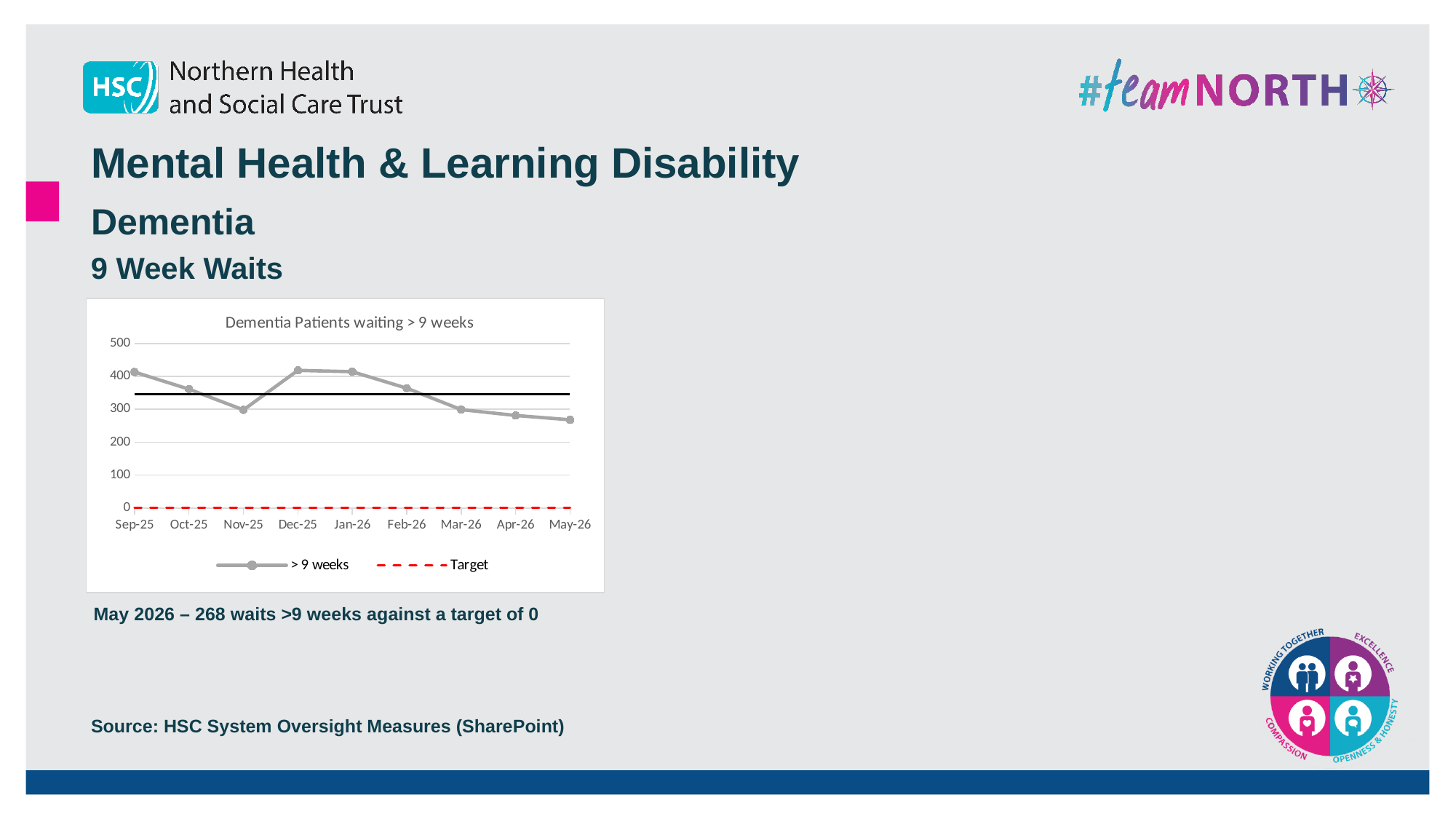
How many months are plotted along the x axis of the chart? 9 Is the value for > 9 weeks in Apr-26 greater or less than 300? less Is the value for > 9 weeks in Dec-25 greater or less than 400? greater Do the > 9 weeks values rise or fall from Jan-26 to May-26? fall How is the Target series drawn on the chart? red dashed line Is the value for > 9 weeks in Feb-26 greater or less than 400? less What is the value of the Target line on the chart? 0 Which is larger, the > 9 weeks value for Sep-25 or for Nov-25? Sep-25 What is the value of the > 9 weeks series for May-26? 268 How many series does the chart legend list? 2 What kind of chart is shown on the slide? line chart What is the title of the chart? Dementia Patients waiting > 9 weeks